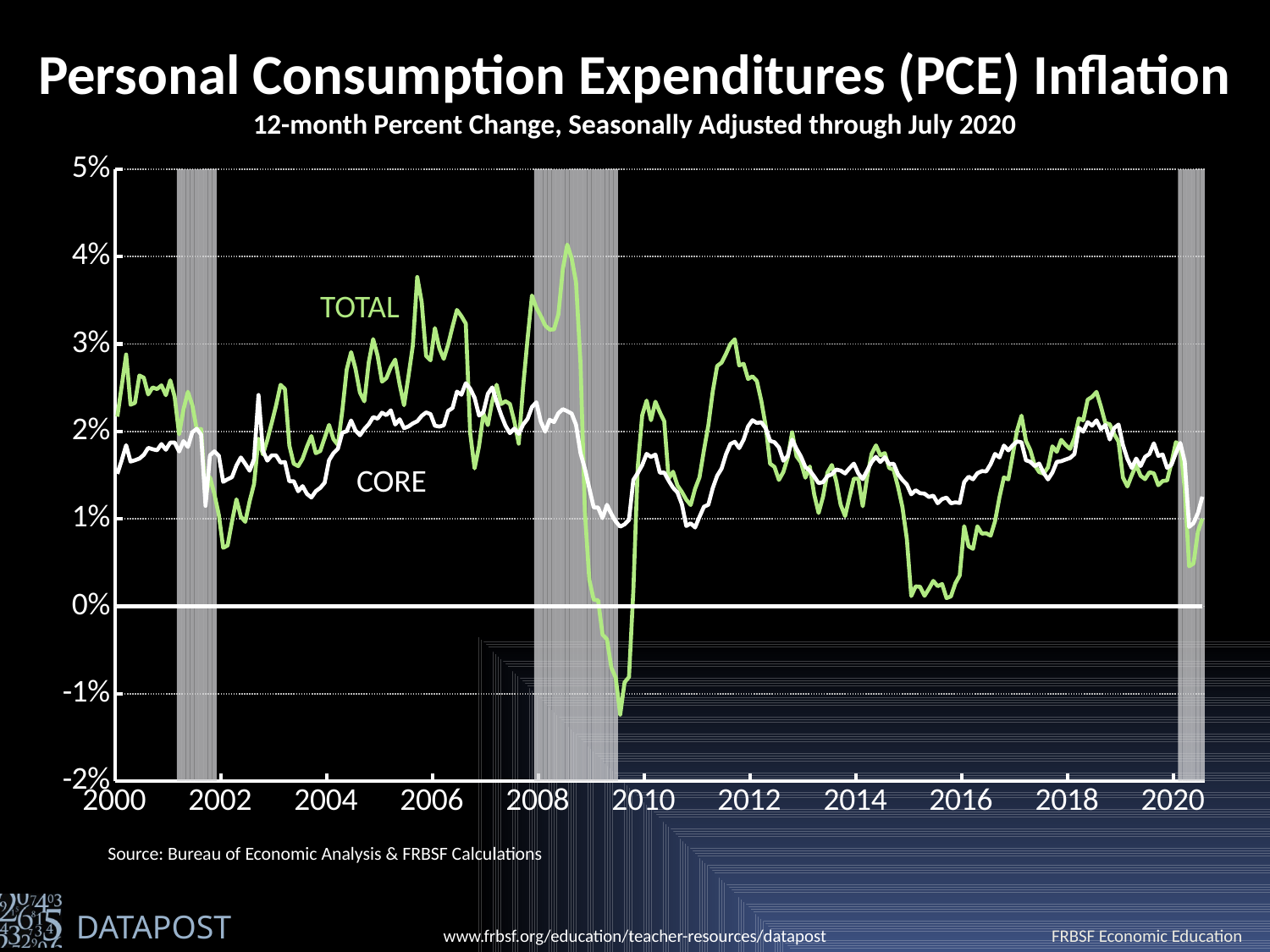
What is the title of the chart? Personal Consumption Expenditures (PCE) Inflation Is the value for TOTAL in 2015 greater or less than 1%? less What colour is the line for the TOTAL series? Green In 2015, which series is higher, TOTAL or CORE? CORE Between mid-2008 and mid-2009, does the TOTAL series rise or fall? fall Which series reaches the highest value on the chart, TOTAL or CORE? TOTAL How many data series are plotted on the chart? 2 In mid-2008, which series is higher, TOTAL or CORE? TOTAL Is the value for TOTAL in mid-2009 greater or less than 0%? less Which series reaches the lowest value on the chart, TOTAL or CORE? TOTAL What kind of chart is shown on the slide? Line chart Is the value for CORE in 2015 greater or less than 1%? greater